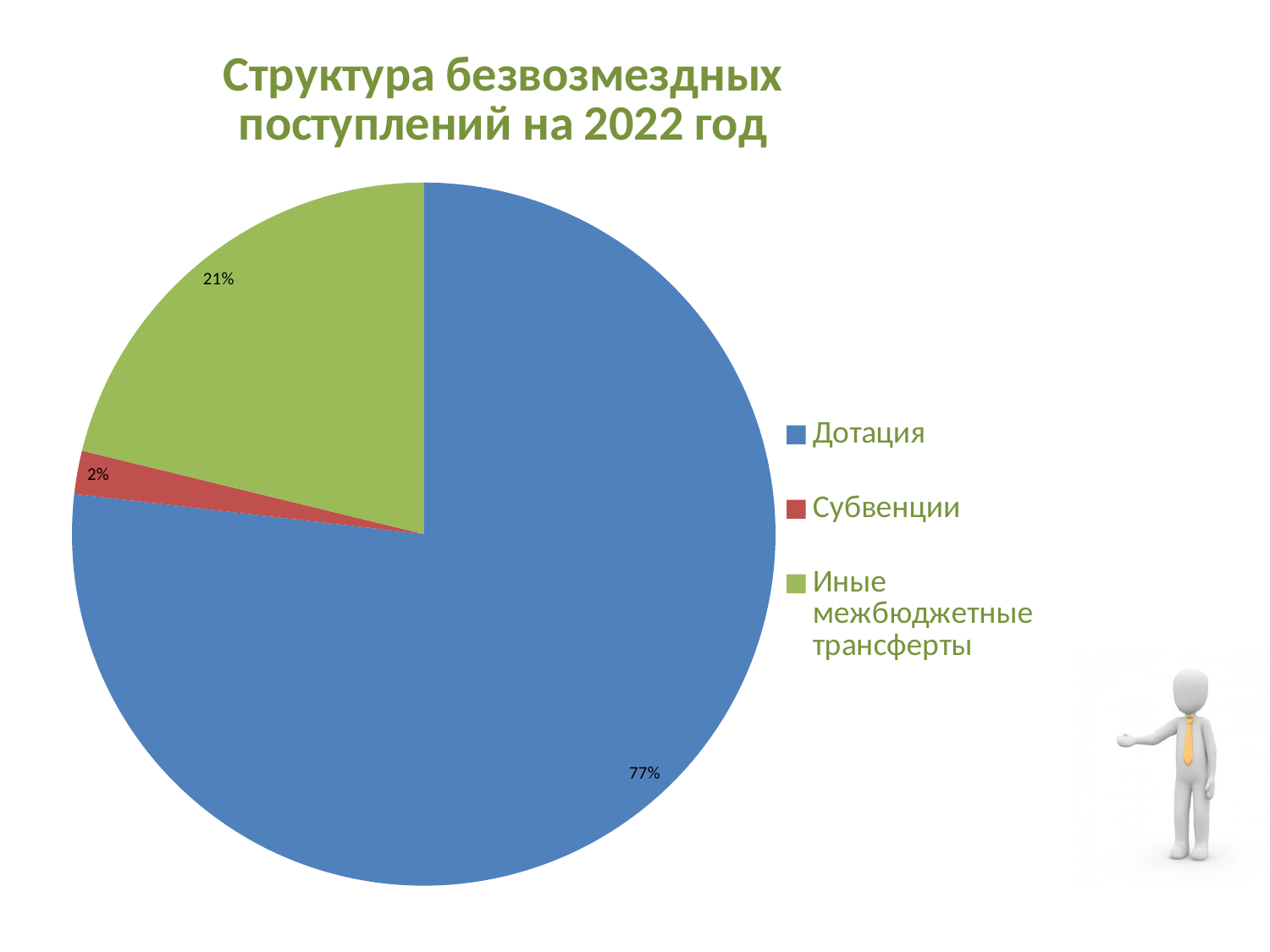
What is the difference in percentage points between Дотация and Иные межбюджетные трансферты? 56 What is the difference in percentage points between Иные межбюджетные трансферты and Субвенции? 19 What kind of chart is shown on the slide? Pie chart What colour is the slice for Субвенции? Red How many categories are shown in the pie chart? 3 Which category has the smallest slice of the pie? Субвенции What share of the pie does Дотация account for? 77% What is the title of the chart? Структура безвозмездных поступлений на 2022 год What share of the pie does Иные межбюджетные трансферты account for? 21% What share of the pie does Субвенции account for? 2% Which category has the largest slice of the pie? Дотация Which is larger: the share for Субвенции or the share for Иные межбюджетные трансферты? Иные межбюджетные трансферты